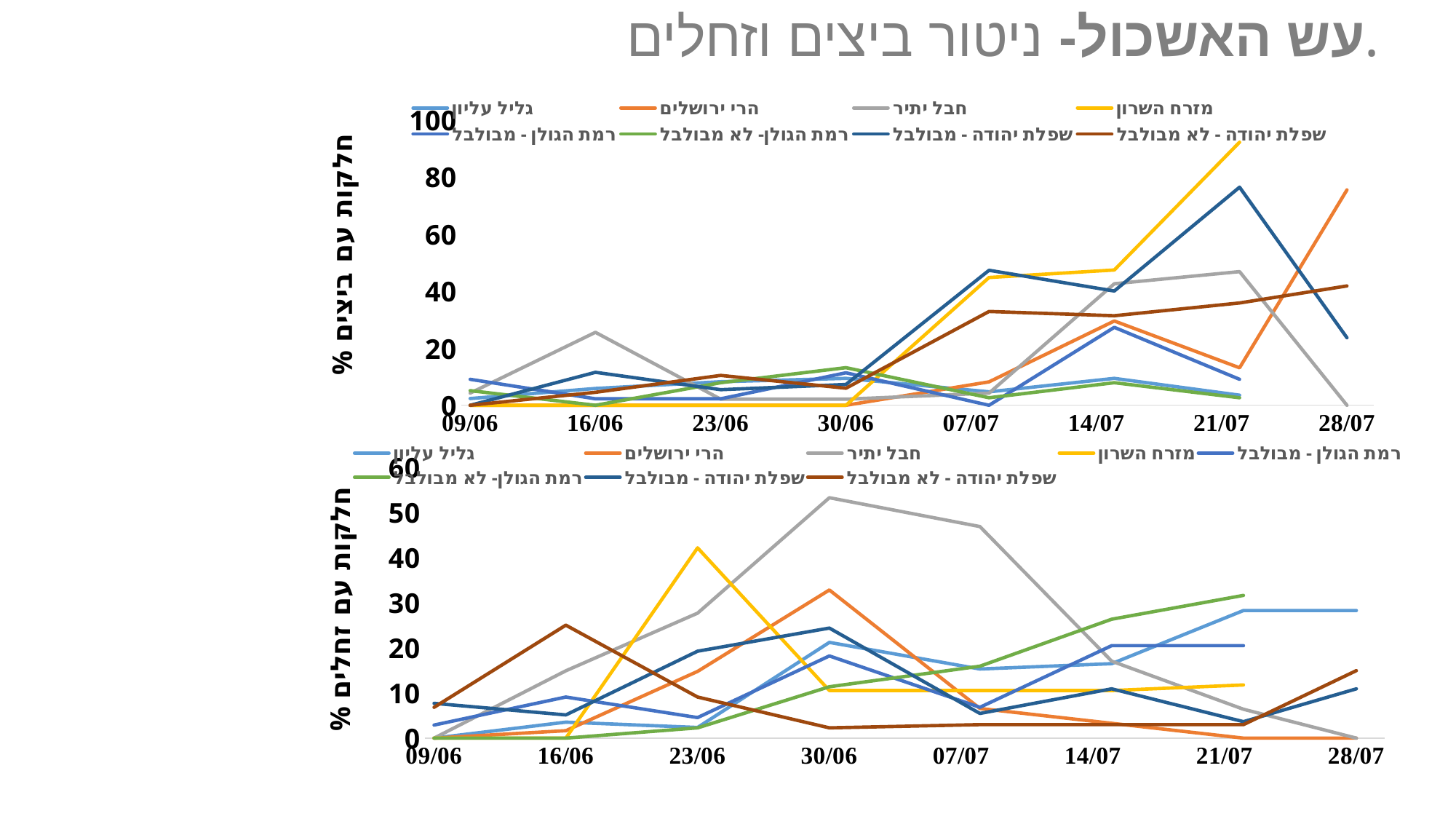
In the top chart, which series reaches the highest value at 21/07? מזרח השרון How many series does the legend of the bottom chart list? 8 In the top chart, does the value for מזרח השרון rise or fall from 30/06 to 21/07? rise What kind of chart is the top chart on the slide? line chart In the top chart, is the value for מזרח השרון at 21/07 greater or less than 80? greater In the bottom chart, which series reaches the highest value at 30/06? חבל יתיר In the top chart, which series has the highest value at 28/07? הרי ירושלים How many dates are shown along the x axis of the top chart? 8 In the bottom chart, is the value for חבל יתיר at 30/06 greater or less than 50? greater In the bottom chart, at 28/07, which is larger: גליל עליון or שפלת יהודה - לא מבולבל? גליל עליון In the top chart, at 28/07, which is larger: הרי ירושלים or שפלת יהודה - לא מבולבל? הרי ירושלים In the bottom chart, does the value for חבל יתיר rise or fall from 30/06 to 28/07? fall